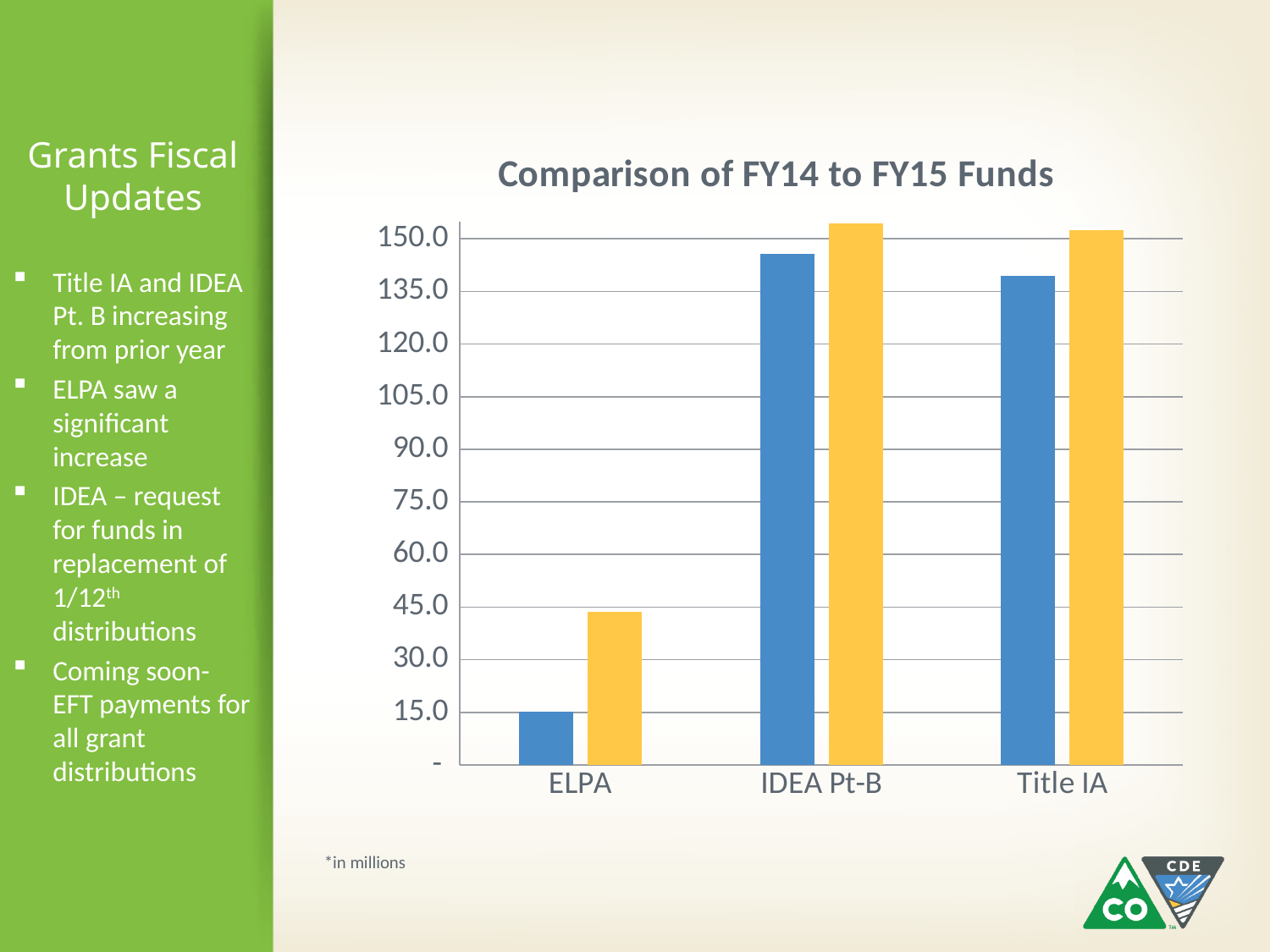
What is the title of the chart? Comparison of FY14 to FY15 Funds Which category has the tallest bar in the chart? IDEA Pt-B What kind of chart is shown on the slide? bar chart According to the footnote below the chart, what unit are the values in? millions For ELPA, which bar is taller, the blue bar or the yellow bar? the yellow bar Which blue bar is taller, IDEA Pt-B or Title IA? IDEA Pt-B Is the value of the yellow bar for ELPA greater or less than 30.0? greater Which category has the lowest bars in the chart? ELPA Is the value of the yellow bar for IDEA Pt-B greater or less than 150.0? greater Is the value of the blue bar for Title IA greater or less than 120.0? greater How many categories are shown on the x axis of the chart? 3